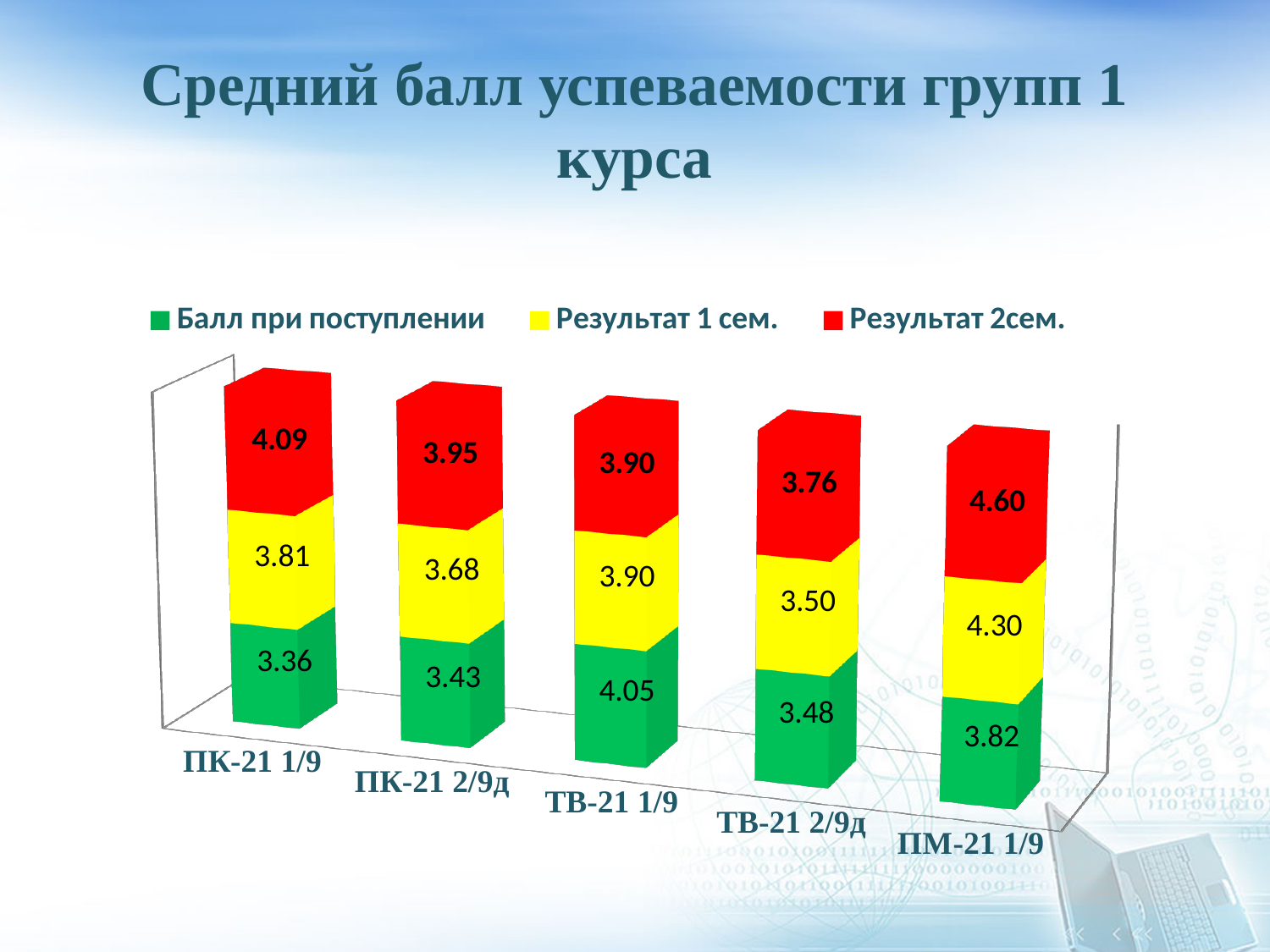
What is the value of "Результат 2сем." for ПМ-21 1/9? 4.60 Which group has the highest "Результат 2сем." value? ПМ-21 1/9 Which is larger for ПК-21 2/9д: "Результат 1 сем." or "Результат 2сем."? Результат 2сем. What type of chart is shown on the slide? stacked bar chart How many groups (categories) are shown on the x axis? 5 What is the total of the three stacked values for ПМ-21 1/9? 12.72 What is the difference between "Результат 2сем." and "Балл при поступлении" for ПК-21 1/9? 0.73 What colour represents "Результат 1 сем." in the chart? yellow What is the value of "Результат 1 сем." for ТВ-21 2/9д? 3.50 Which group has the lowest "Балл при поступлении" value? ПК-21 1/9 How many series does the legend list? 3 What is the value of "Балл при поступлении" for ТВ-21 1/9? 4.05